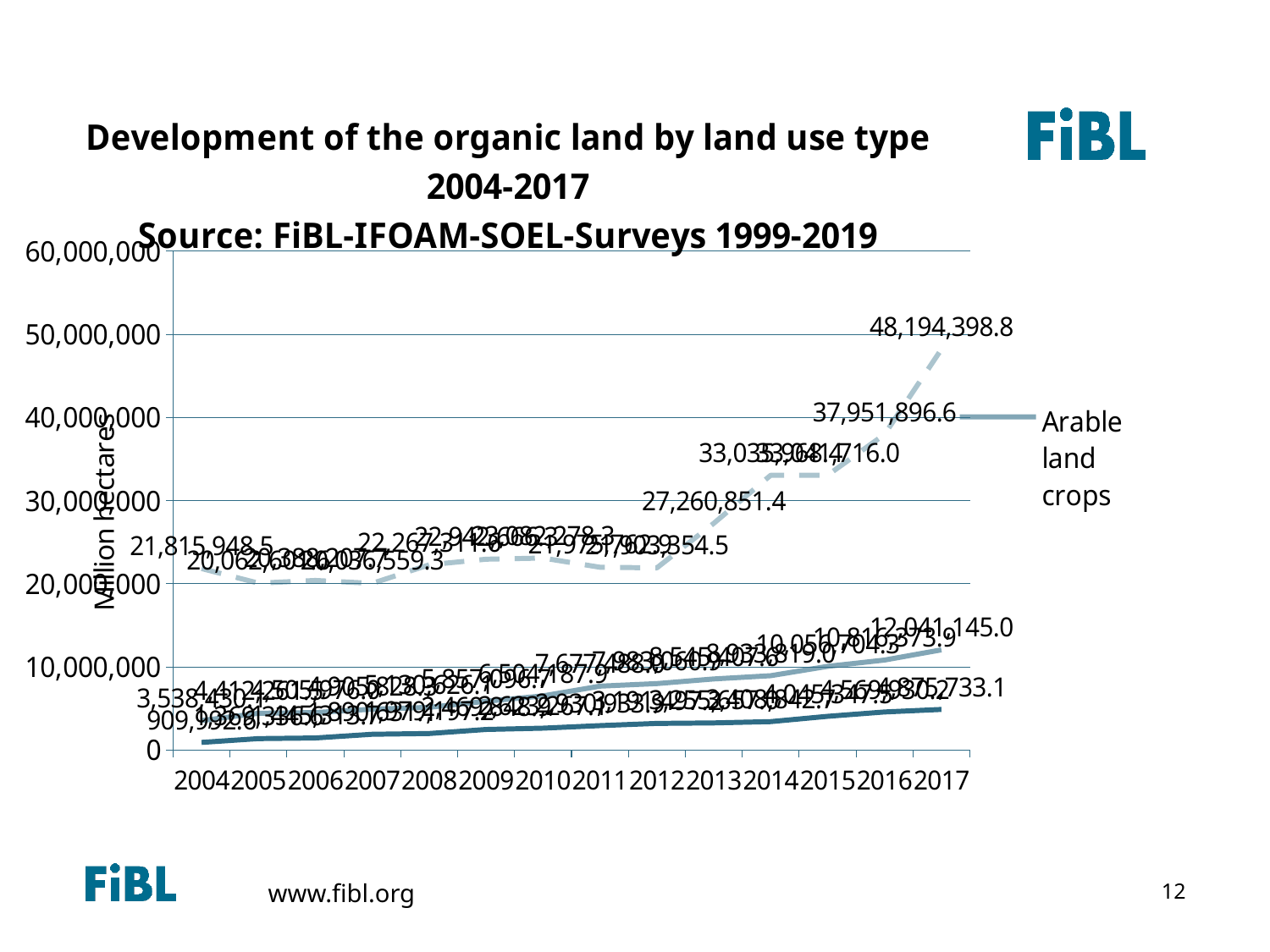
What is the value labelled for 2017 on the highest (dashed) line of the chart? 48,194,398.8 Is the 2017 value of the highest (dashed) line greater or less than 40,000,000? greater On the highest (dashed) line, by how much did the value increase from 2016 to 2017? 10,242,502.2 What is the value labelled for 2016 on the highest (dashed) line of the chart? 37,951,896.6 How many years are shown along the x axis of the chart? 14 Does the highest (dashed) line rise or fall between 2013 and 2017? rise On the highest (dashed) line, by how much did the value increase from 2013 to 2016? 10,691,045.2 What type of chart is shown on the slide? line chart What is the value labelled for 2004 on the highest (dashed) line of the chart? 21,815,948.5 What is the value labelled for 2013 on the highest (dashed) line of the chart? 27,260,851.4 What is the label on the vertical axis of the chart? Million hectares In which year does the highest (dashed) line reach its maximum value? 2017